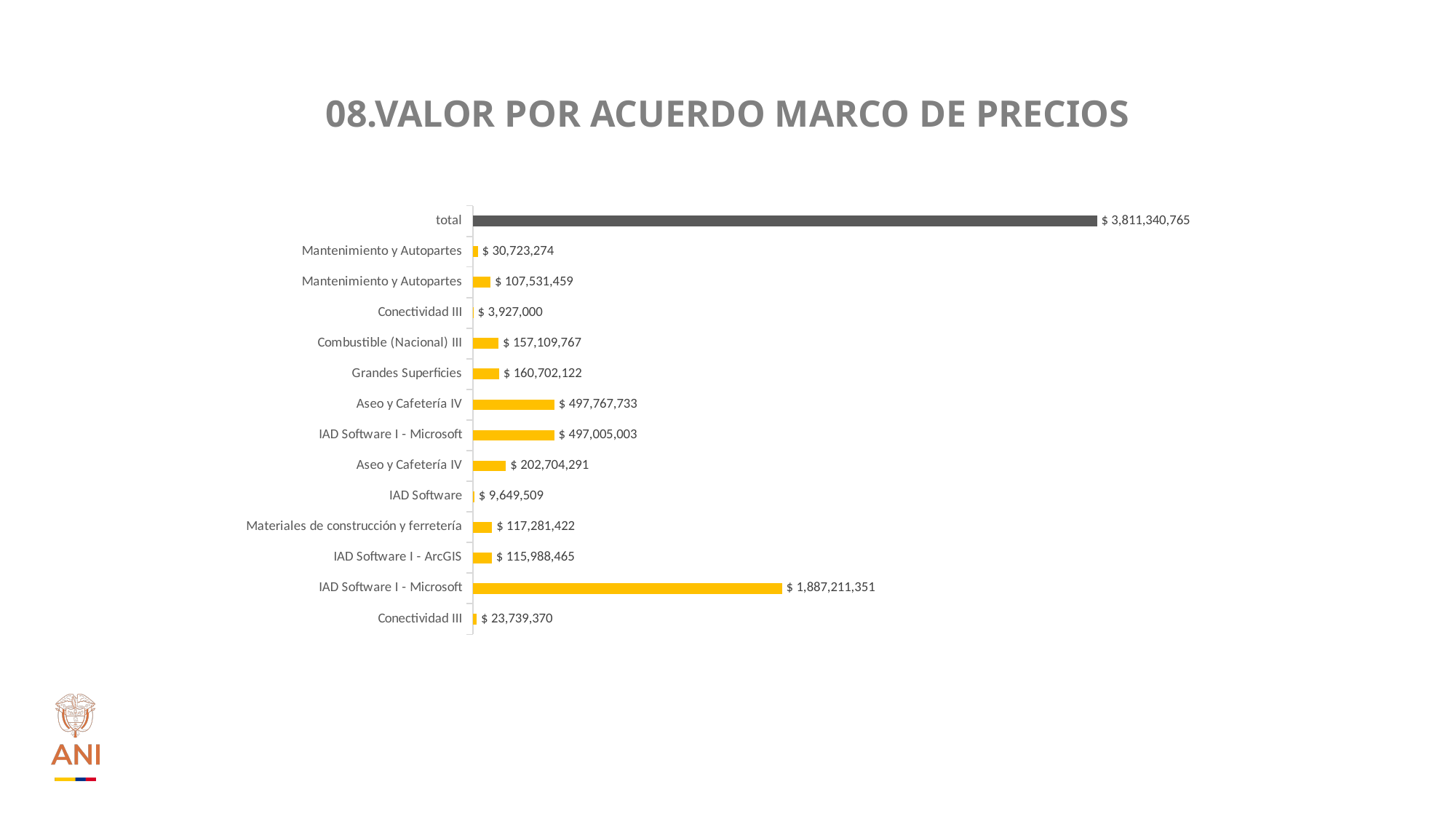
What is the value for Grandes Superficies? $ 160,702,122 What is the difference between Grandes Superficies and Combustible (Nacional) III? $ 3,592,355 How many bars are shown on the chart, including the total bar? 14 What is the value for IAD Software? $ 9,649,509 What is the value of the total bar? $ 3,811,340,765 Apart from the total bar, which category has the largest value? IAD Software I - Microsoft What is the value for Combustible (Nacional) III? $ 157,109,767 What is the smallest value shown on the chart? $ 3,927,000 What is the value for IAD Software I - ArcGIS? $ 115,988,465 What type of chart is shown on the slide? Bar chart Which is larger, Materiales de construcción y ferretería or IAD Software I - ArcGIS? Materiales de construcción y ferretería What is the value for Materiales de construcción y ferretería? $ 117,281,422